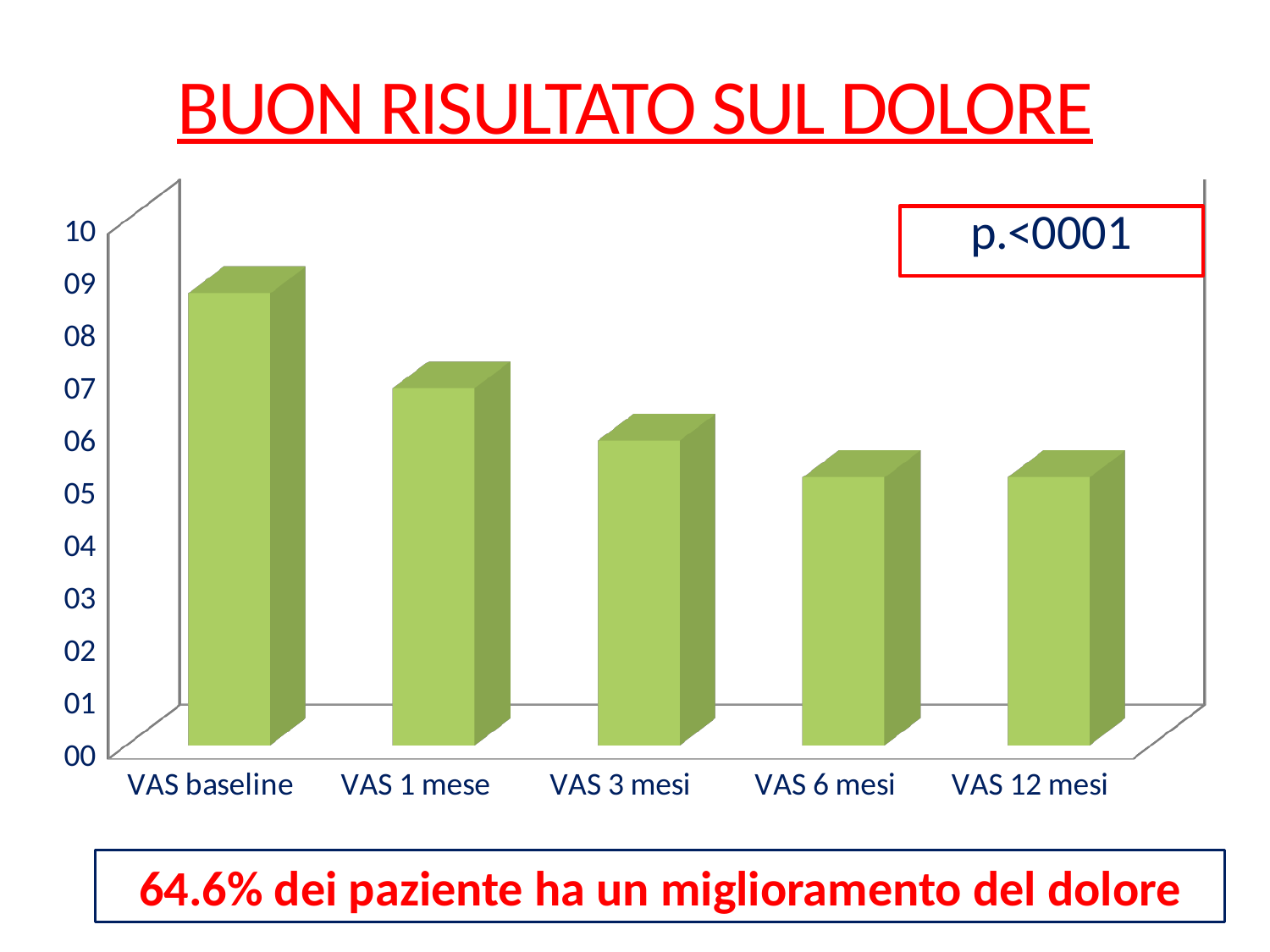
Is the value for VAS 3 mesi greater or less than 7? less What kind of chart is shown on the slide? bar chart How many categories are shown on the x axis of the chart? 5 Is the value for VAS 6 mesi greater or less than 4? greater Do the values rise or fall from VAS baseline to VAS 12 mesi? fall Which category has the highest value in the chart? VAS baseline What p-value is shown in the box at the top right of the chart? p.<0001 Which is larger, the value for VAS baseline or the value for VAS 1 mese? VAS baseline What is the title of the slide containing the chart? BUON RISULTATO SUL DOLORE Which is larger, the value for VAS 1 mese or the value for VAS 3 mesi? VAS 1 mese Is the value for VAS 1 mese greater or less than 8? less